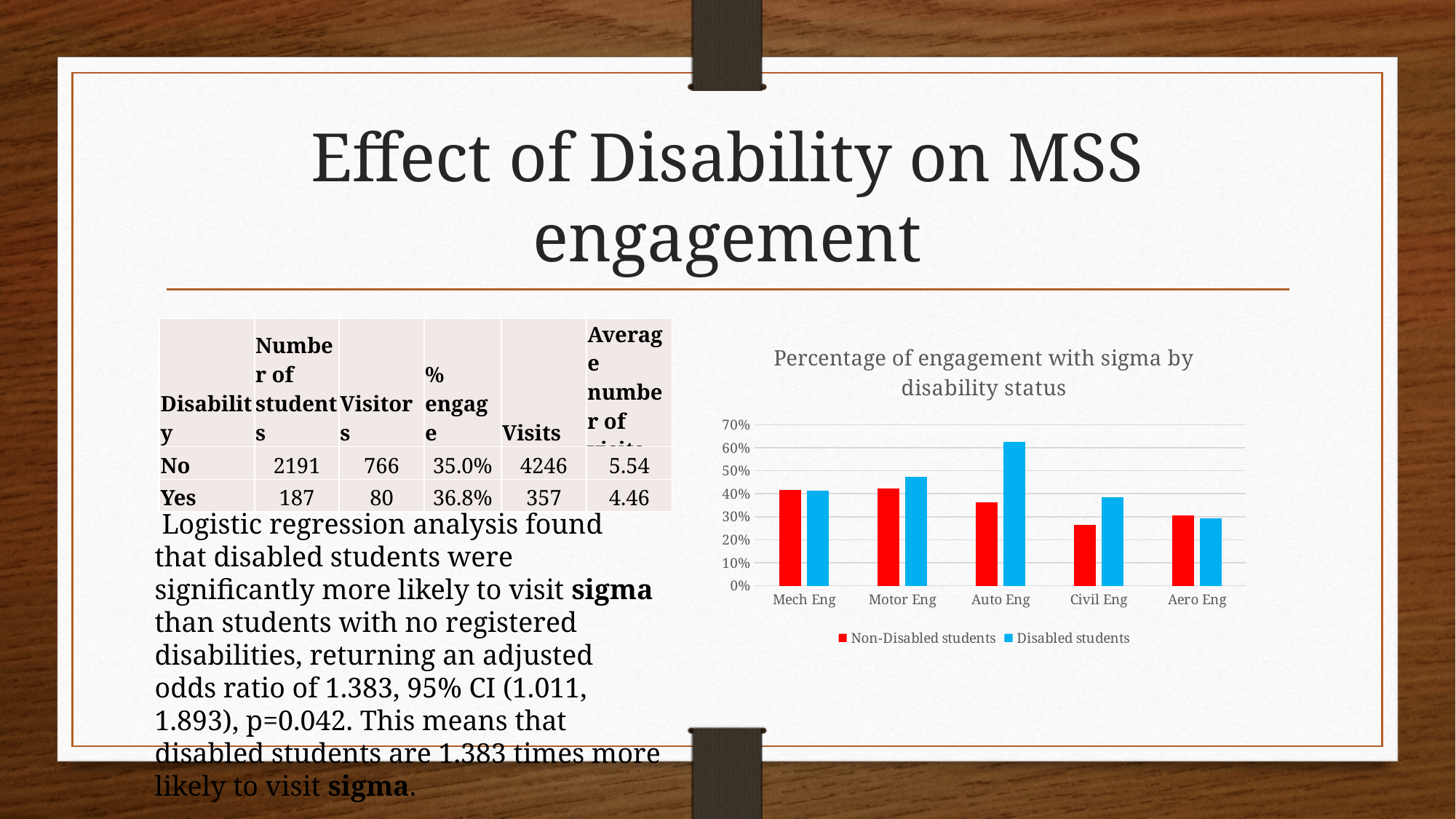
Which category has the lowest value for Disabled students? Aero Eng Is the value for Non-Disabled students in Civil Eng greater or less than 30%? less What is the title of the chart? Percentage of engagement with sigma by disability status Is the value for Disabled students in Motor Eng greater or less than 50%? less Which category has the lowest value for Non-Disabled students? Civil Eng What kind of chart is shown on the slide? bar chart How many categories are shown on the x axis of the chart? 5 How many series does the chart legend list? 2 For Auto Eng, which is larger: the value for Disabled students or for Non-Disabled students? Disabled students For Civil Eng, which is larger: the value for Disabled students or for Non-Disabled students? Disabled students Is the value for Disabled students in Auto Eng greater or less than 50%? greater Which category has the highest value for Disabled students? Auto Eng